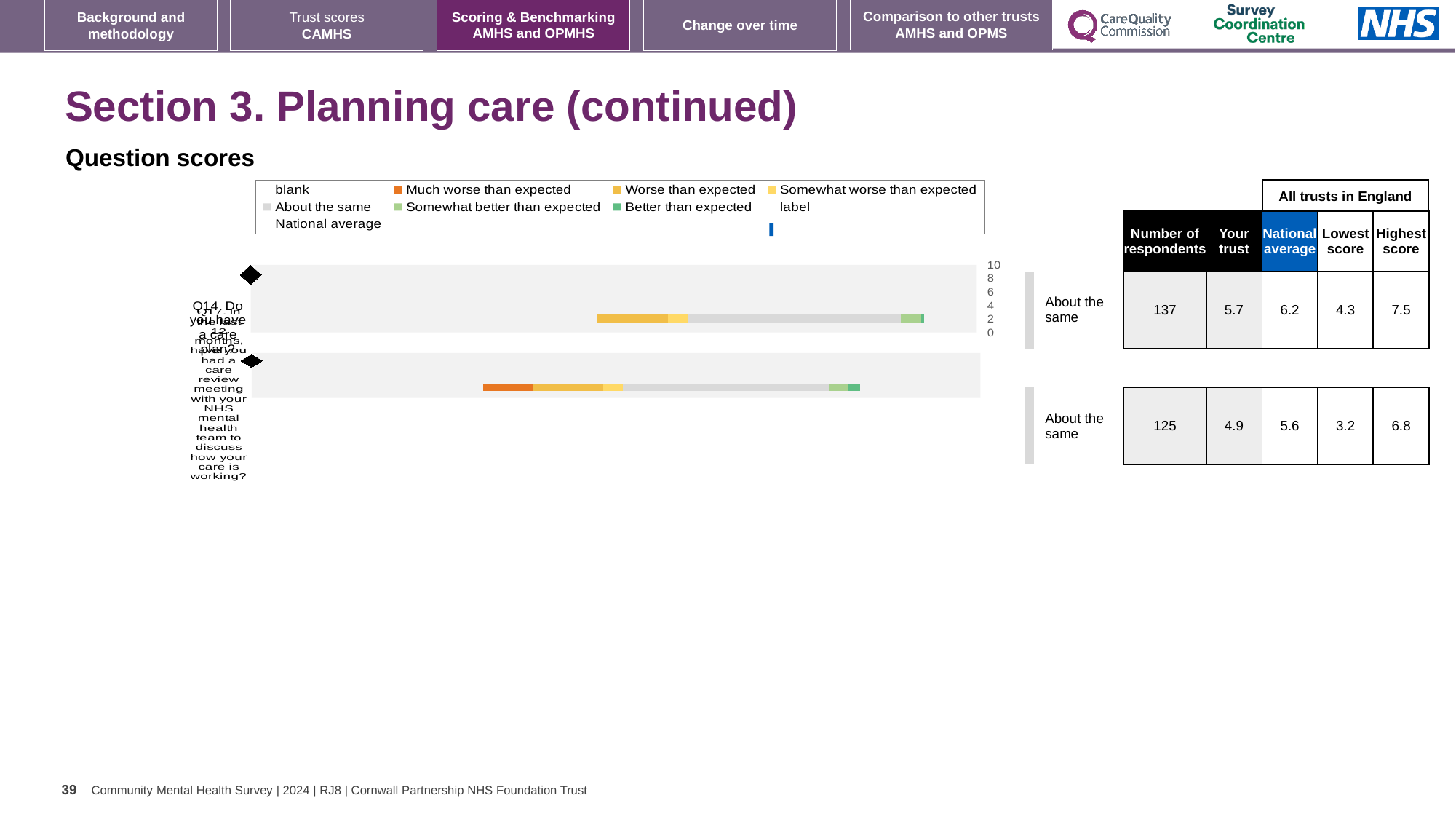
What is the difference between the highest score and the lowest score for Q14 in the table? 3.2 What colour represents 'Better than expected' in the chart legend? green What kind of chart is shown under 'Question scores'? bar chart Which question has the higher 'Your trust' score, Q14 or Q17? Q14 In the table beside the chart, what is the lowest score for Q17? 3.2 In the table beside the chart, what is the 'Your trust' score for Q17 (care review meeting)? 4.9 What is the highest score for Q17 in the table beside the chart? 6.8 What benchmark category is shown for Q17 next to the chart? About the same How many questions (bars) are plotted in the chart? 2 In the table beside the chart, what is the national average for Q14? 6.2 What colour represents 'Much worse than expected' in the chart legend? orange In the table beside the chart, what is the number of respondents for Q14 (Do you have a care plan?)? 137